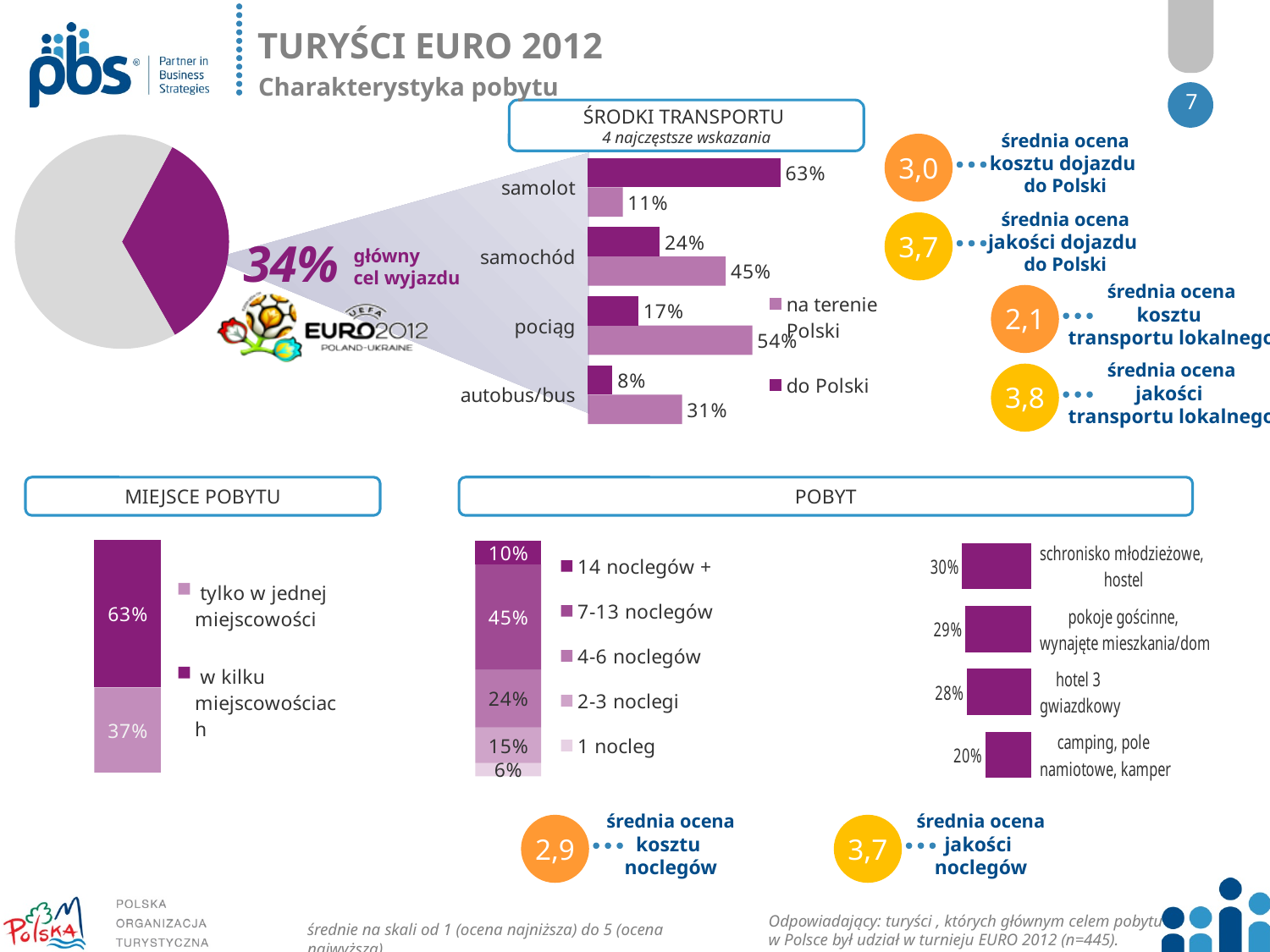
In the ŚRODKI TRANSPORTU chart, what is the value for samolot in the 'do Polski' series? 63% In the POBYT section bar chart of accommodation types, what is the value for 'hotel 3 gwiazdkowy'? 28% In the ŚRODKI TRANSPORTU chart, how many series does the legend list? 2 What type of chart is the ŚRODKI TRANSPORTU chart? bar chart In the POBYT section bar chart of accommodation types, which category has the lowest value? camping, pole namiotowe, kamper In the POBYT stacked bar, what is the value for the '7-13 noclegów' segment? 45% In the POBYT stacked bar, what is the total of all segments? 100% In the ŚRODKI TRANSPORTU chart, which category has the lowest value in the 'do Polski' series? autobus/bus In the ŚRODKI TRANSPORTU chart, what is the value for pociąg in the 'na terenie Polski' series? 54% In the ŚRODKI TRANSPORTU chart, how many transport categories are shown? 4 In the pie chart at the top left, what share is labelled as 'główny cel wyjazdu'? 34% In the ŚRODKI TRANSPORTU chart, what is the difference between the 'na terenie Polski' and 'do Polski' values for samochód? 21%